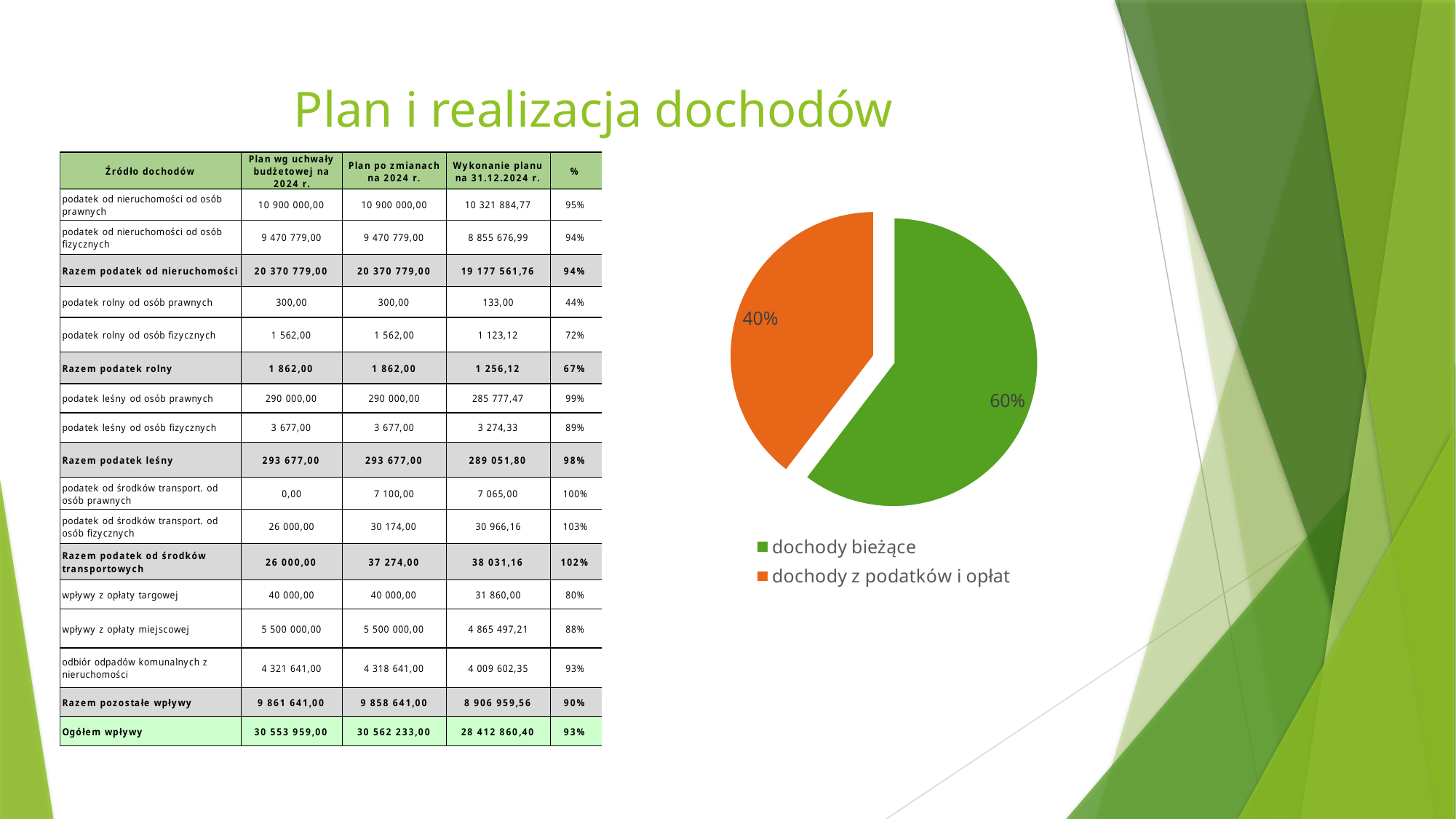
What share of the pie chart does "dochody z podatków i opłat" represent? 40% How many entries does the pie chart legend list? 2 How many slices does the pie chart have? 2 What is the difference in percentage points between the "dochody bieżące" slice and the "dochody z podatków i opłat" slice? 20 percentage points What share of the pie chart does "dochody bieżące" represent? 60% Which is larger in the pie chart: "dochody bieżące" or "dochody z podatków i opłat"? dochody bieżące What colour is the "dochody z podatków i opłat" slice in the pie chart? orange What colour is the "dochody bieżące" slice in the pie chart? green What kind of chart is shown on the slide? pie chart Which slice of the pie chart is the smallest? dochody z podatków i opłat Is the share of "dochody z podatków i opłat" in the pie chart greater or less than 50%? less Which slice of the pie chart is the largest? dochody bieżące